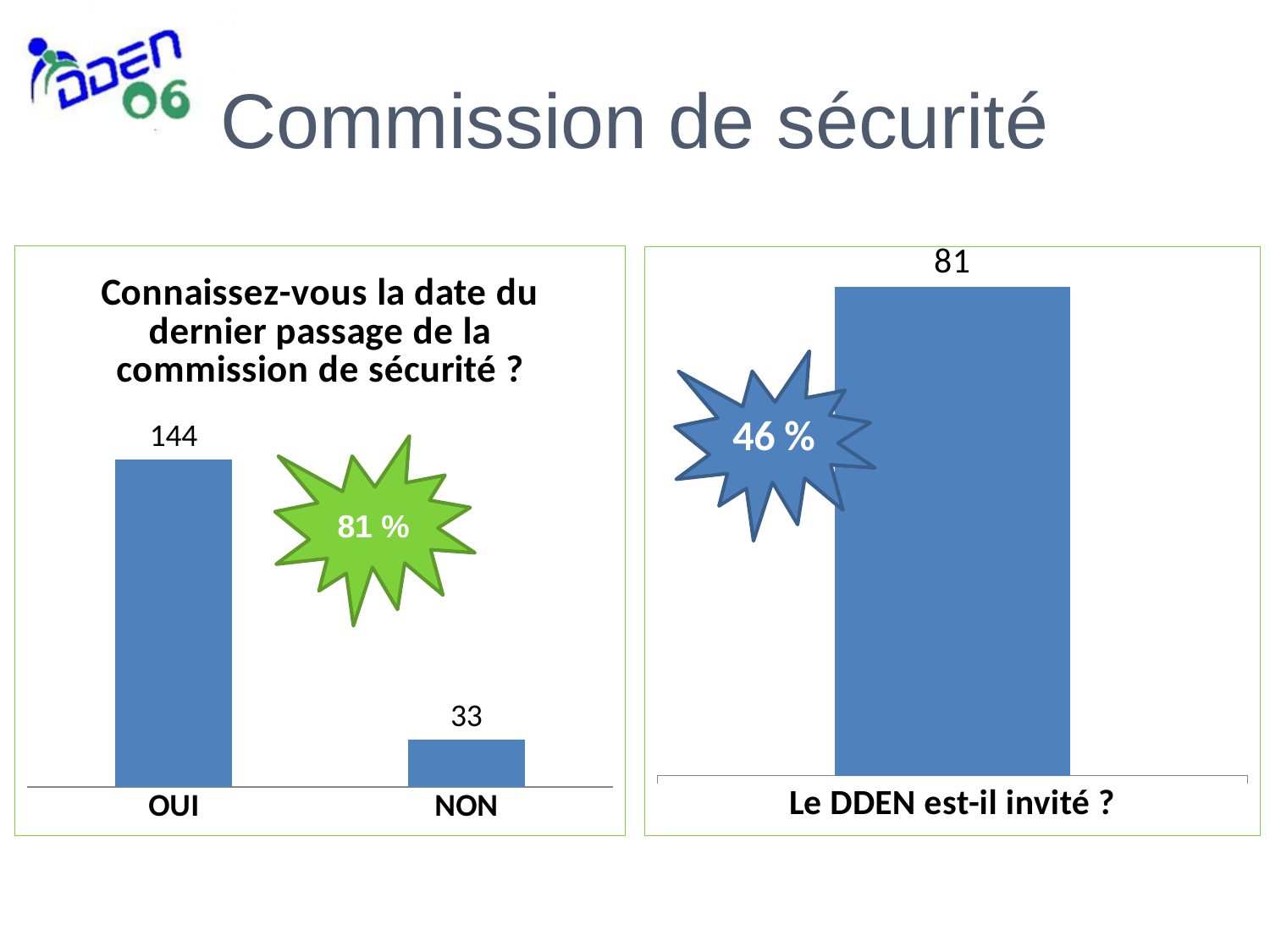
What percentage is shown in the blue starburst on the right chart? 46 % In the left chart 'Connaissez-vous la date du dernier passage de la commission de sécurité ?', which is larger, OUI or NON? OUI How many categories are shown in the left chart 'Connaissez-vous la date du dernier passage de la commission de sécurité ?'? 2 In the left chart 'Connaissez-vous la date du dernier passage de la commission de sécurité ?', which category has the highest value? OUI In the left chart 'Connaissez-vous la date du dernier passage de la commission de sécurité ?', which category has the lowest value? NON In the left chart 'Connaissez-vous la date du dernier passage de la commission de sécurité ?', what is the value for OUI? 144 What kind of chart is the left chart 'Connaissez-vous la date du dernier passage de la commission de sécurité ?'? bar chart In the right chart, what is the value for 'Le DDEN est-il invité ?'? 81 What percentage is shown in the green starburst on the left chart? 81 % How many bars are shown in the right chart 'Le DDEN est-il invité ?'? 1 In the left chart 'Connaissez-vous la date du dernier passage de la commission de sécurité ?', what is the value for NON? 33 In the left chart 'Connaissez-vous la date du dernier passage de la commission de sécurité ?', what is the difference between the OUI and NON values? 111